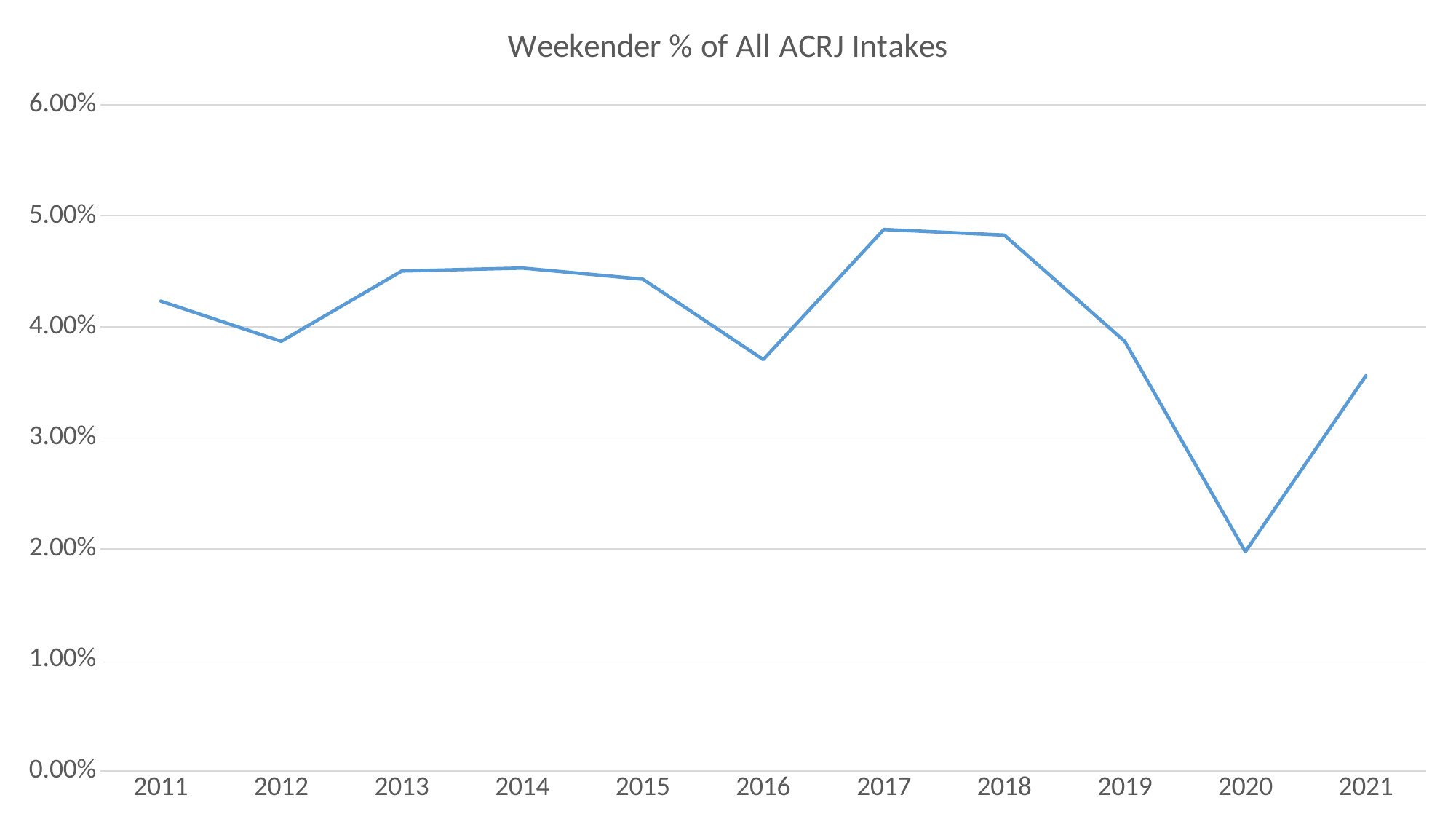
Does the value rise or fall from 2018 to 2020? fall Which year has the lowest Weekender % of All ACRJ Intakes? 2020 Which year has the higher value, 2014 or 2016? 2014 What kind of chart is shown on the slide? line chart Is the value for 2016 greater or less than 4.00%? less Is the value for 2021 greater or less than 3.00%? greater What is the title of the chart? Weekender % of All ACRJ Intakes Is the value for 2020 greater or less than 3.00%? less How many years are plotted on the x axis? 11 Which year has the higher value, 2011 or 2021? 2011